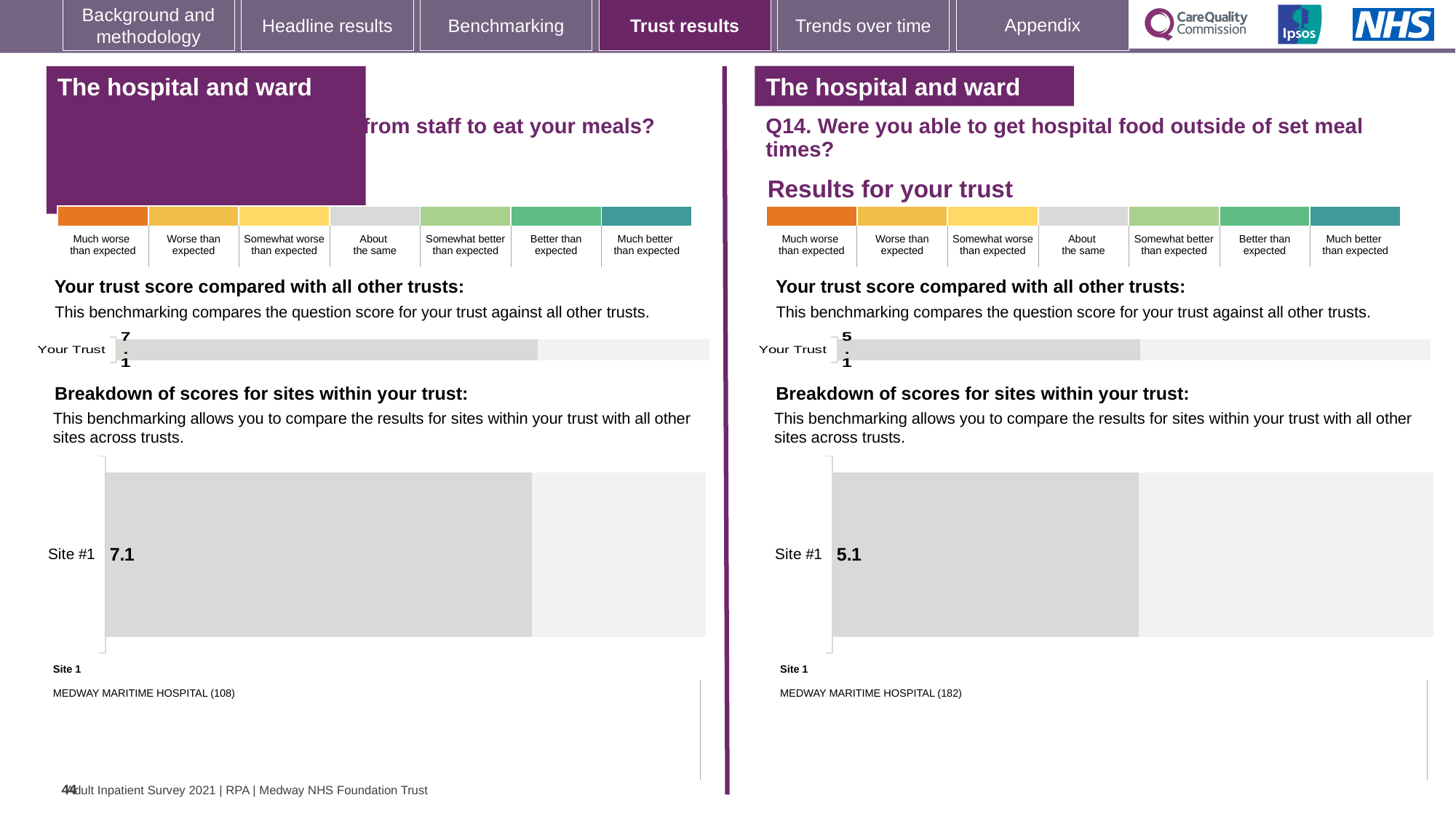
On the left-hand chart, which hospital is listed as Site 1? MEDWAY MARITIME HOSPITAL (108) What is the difference between the Your Trust score on the left-hand chart (7.1) and the Your Trust score on the right-hand chart for Q14 (5.1)? 2.0 On the right-hand chart for Q14, is the Your Trust score greater or less than 6? less On the left-hand chart (question ending 'from staff to eat your meals?'), what is the score shown for Site #1? 7.1 How many sites are shown in the breakdown of scores for sites within your trust on the right-hand chart for Q14? 1 On the left-hand chart (question ending 'from staff to eat your meals?'), what is the score shown for Your Trust? 7.1 What type of chart is used to show the breakdown of scores for sites within your trust on the right-hand side for Q14? Bar chart On the right-hand chart for Q14, what is the score shown for Site #1? 5.1 Which is larger: the Site #1 score on the left-hand chart or the Site #1 score on the right-hand chart for Q14? Left-hand chart (7.1) On the right-hand chart for Q14, which hospital is listed as Site 1? MEDWAY MARITIME HOSPITAL (182) On the right-hand chart for Q14 (hospital food outside of set meal times), what is the score shown for Your Trust? 5.1 How many sites are shown in the breakdown of scores for sites within your trust on the left-hand chart? 1